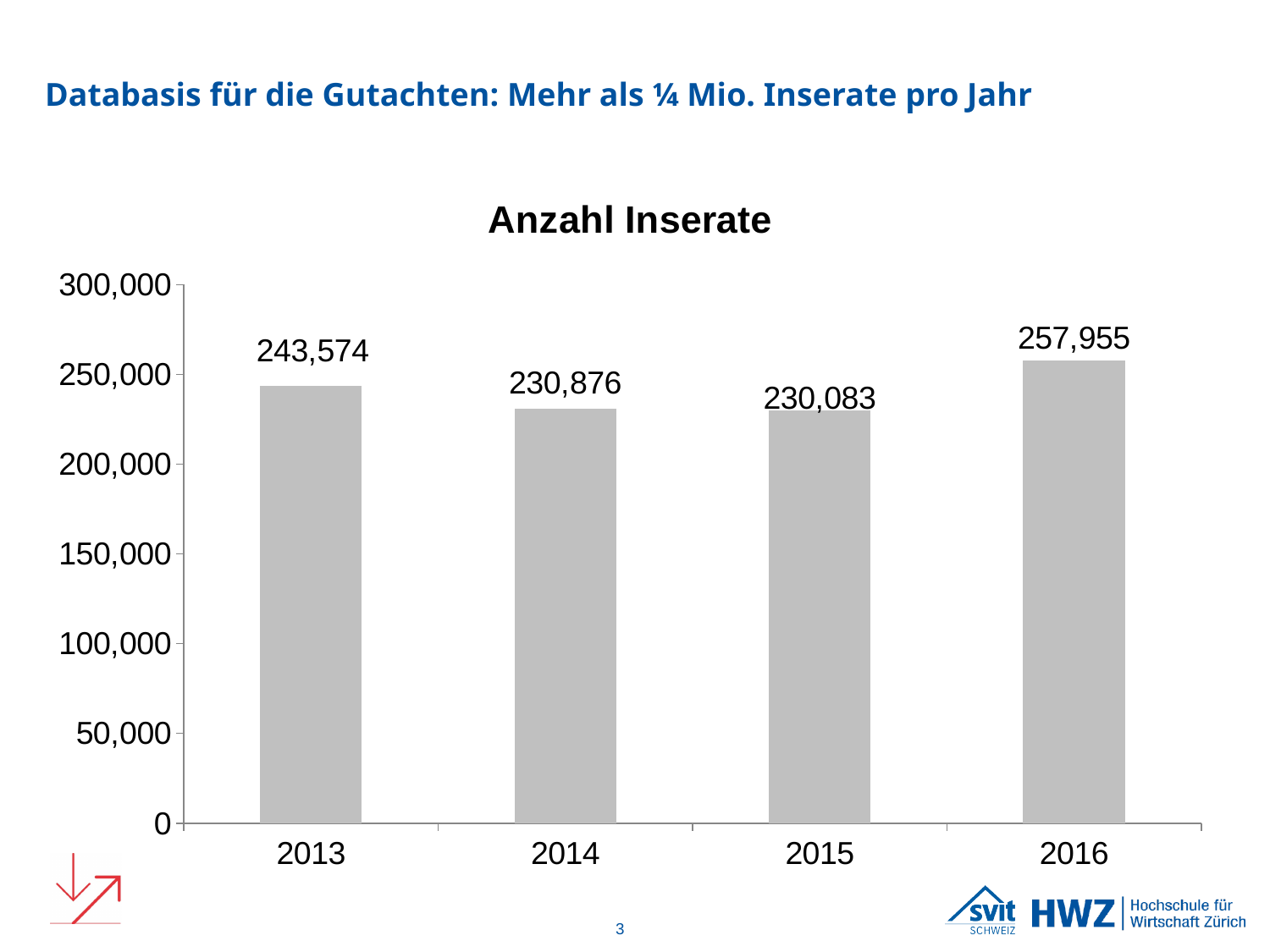
What kind of chart is shown on the slide? bar chart What is the title of the chart? Anzahl Inserate What is the value for 2015 in the Anzahl Inserate chart? 230,083 Which year has the highest number of Inserate? 2016 How many years are shown in the chart? 4 What is the value for 2016 in the Anzahl Inserate chart? 257,955 What is the difference between the values for 2014 and 2015? 793 Which year has the lowest number of Inserate? 2015 Which is larger, the value for 2013 or the value for 2014? 2013 What is the difference between the values for 2016 and 2013? 14,381 What is the value for 2013 in the Anzahl Inserate chart? 243,574 Is the value for 2016 greater or less than 250,000? greater